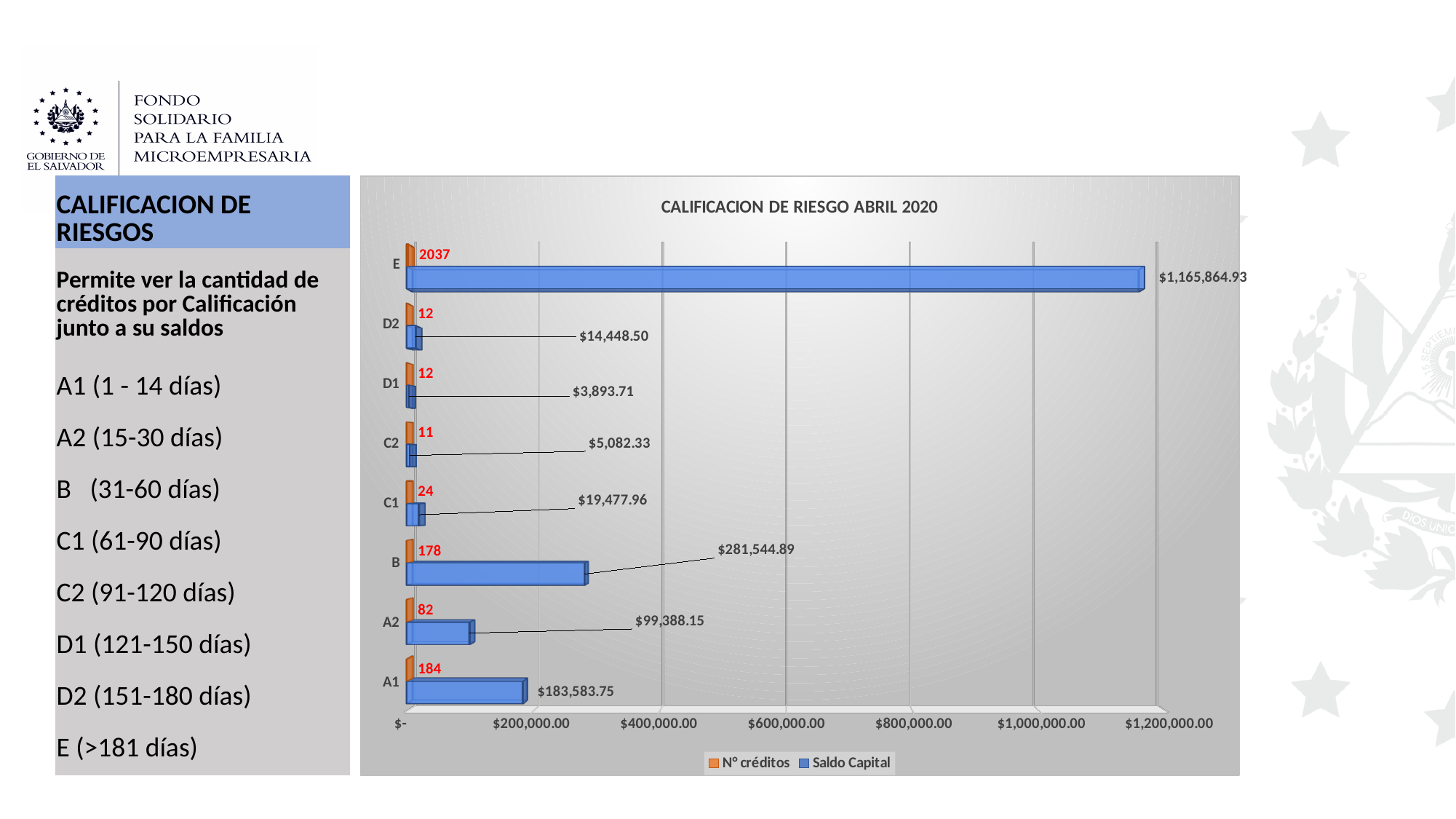
Which category has the lowest N° créditos? C2 How many categories are shown on the chart? 8 Which category has the highest Saldo Capital? E How many series does the legend list? 2 Which has a larger Saldo Capital, B or A1? B Which category has the lowest Saldo Capital? D1 What is the Saldo Capital value for category E? $1,165,864.93 What type of chart is shown on the slide? Bar chart What is the N° créditos value for category C1? 24 What is the N° créditos value for category B? 178 What is the Saldo Capital value for category A2? $99,388.15 What is the difference in N° créditos between A1 and A2? 102